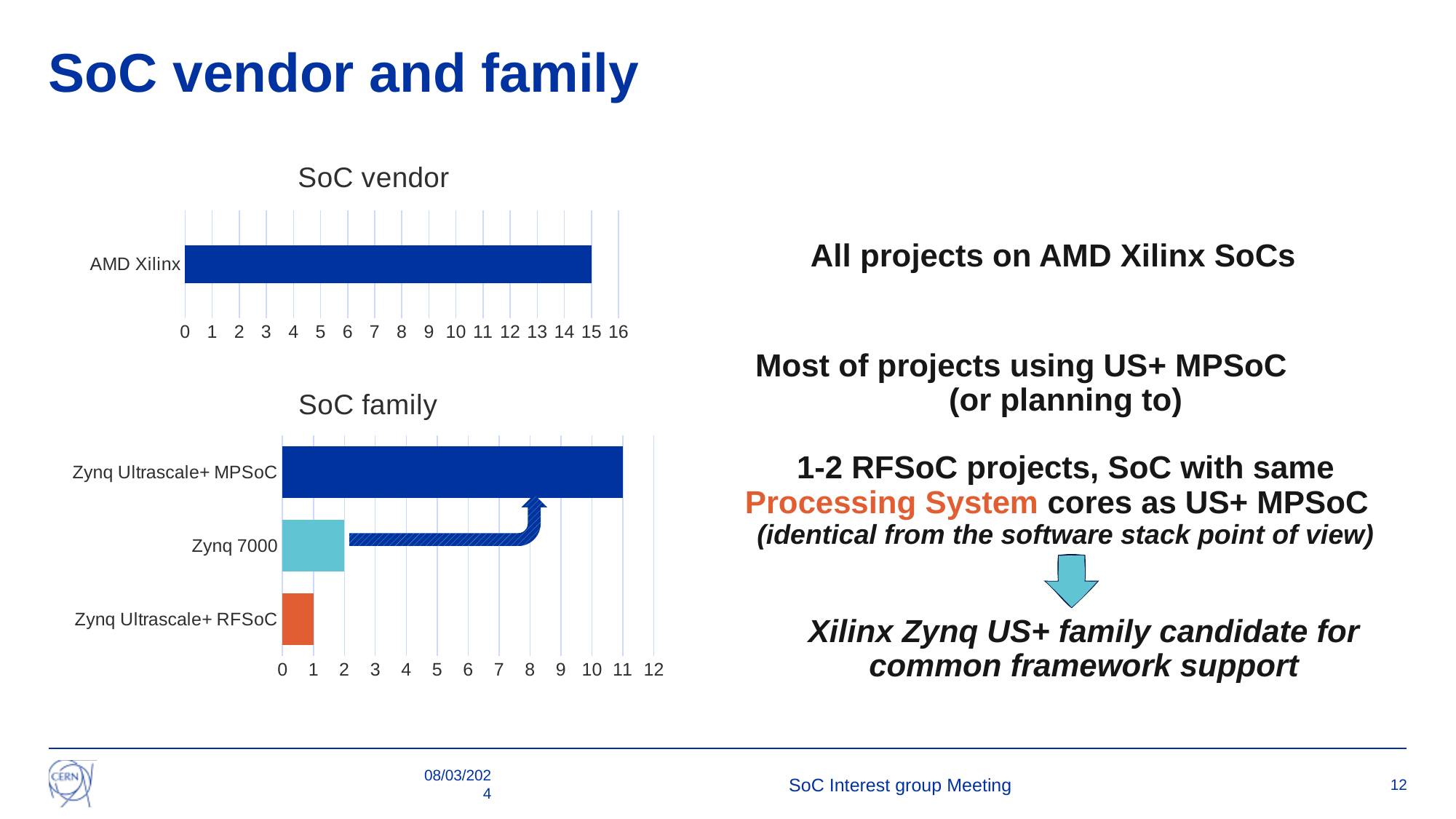
In the SoC family chart, what is the value for Zynq Ultrascale+ RFSoC? 1 In the SoC family chart, what is the value for Zynq Ultrascale+ MPSoC? 11 In the SoC family chart, what is the value for Zynq 7000? 2 In the SoC family chart, which category has the highest value? Zynq Ultrascale+ MPSoC In the SoC vendor chart, what is the value for AMD Xilinx? 15 In the SoC family chart, which category has the lowest value? Zynq Ultrascale+ RFSoC In the SoC family chart, which is larger, the value for Zynq 7000 or the value for Zynq Ultrascale+ RFSoC? Zynq 7000 In the SoC family chart, what is the difference between the values for Zynq Ultrascale+ MPSoC and Zynq 7000? 9 What kind of chart is the SoC vendor chart? bar chart In the SoC vendor chart, how many categories are shown? 1 In the SoC family chart, is the value for Zynq Ultrascale+ MPSoC greater or less than 10? greater In the SoC family chart, how many categories are shown? 3